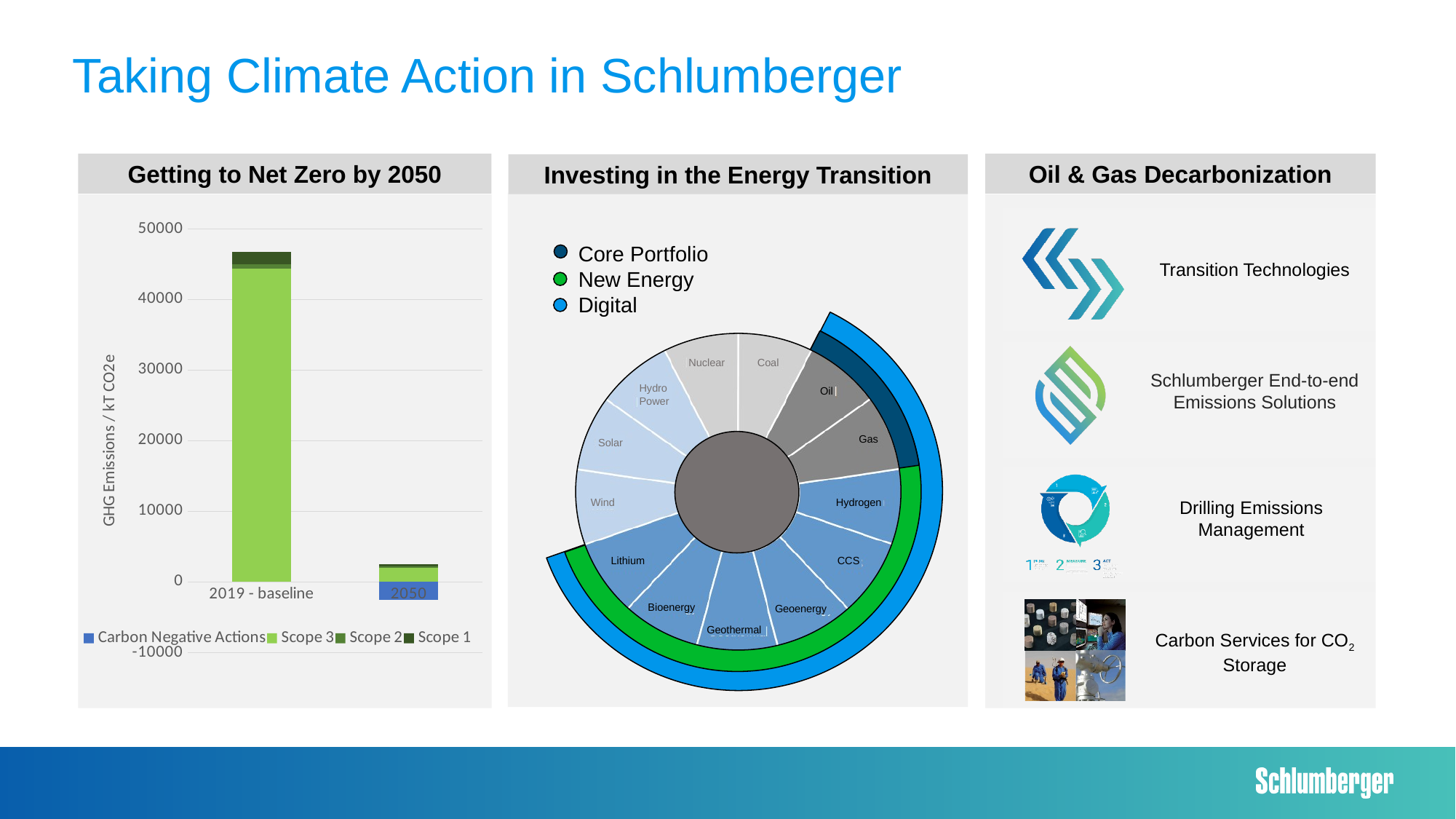
In the "Getting to Net Zero by 2050" chart, do total emissions rise or fall from 2019 - baseline to 2050? fall In the "Investing in the Energy Transition" diagram, what are the three legend entries? Core Portfolio, New Energy, Digital In the "Getting to Net Zero by 2050" chart, is the Carbon Negative Actions value for 2050 greater or less than 0? less In the "Getting to Net Zero by 2050" chart, is the total bar height for 2019 - baseline greater or less than 40000? greater In the "Getting to Net Zero by 2050" chart, which series makes up the largest part of the 2019 - baseline bar? Scope 3 In the "Getting to Net Zero by 2050" chart, how many series does the legend list? 4 What kind of chart is shown under "Getting to Net Zero by 2050"? Stacked bar chart In the "Getting to Net Zero by 2050" chart, is the Scope 3 value for 2050 greater or less than 10000? less In the "Getting to Net Zero by 2050" chart, how many categories are shown on the x axis? 2 What is the y-axis label of the "Getting to Net Zero by 2050" chart? GHG Emissions / kT CO2e In the "Getting to Net Zero by 2050" chart, which category has the higher total emissions, 2019 - baseline or 2050? 2019 - baseline